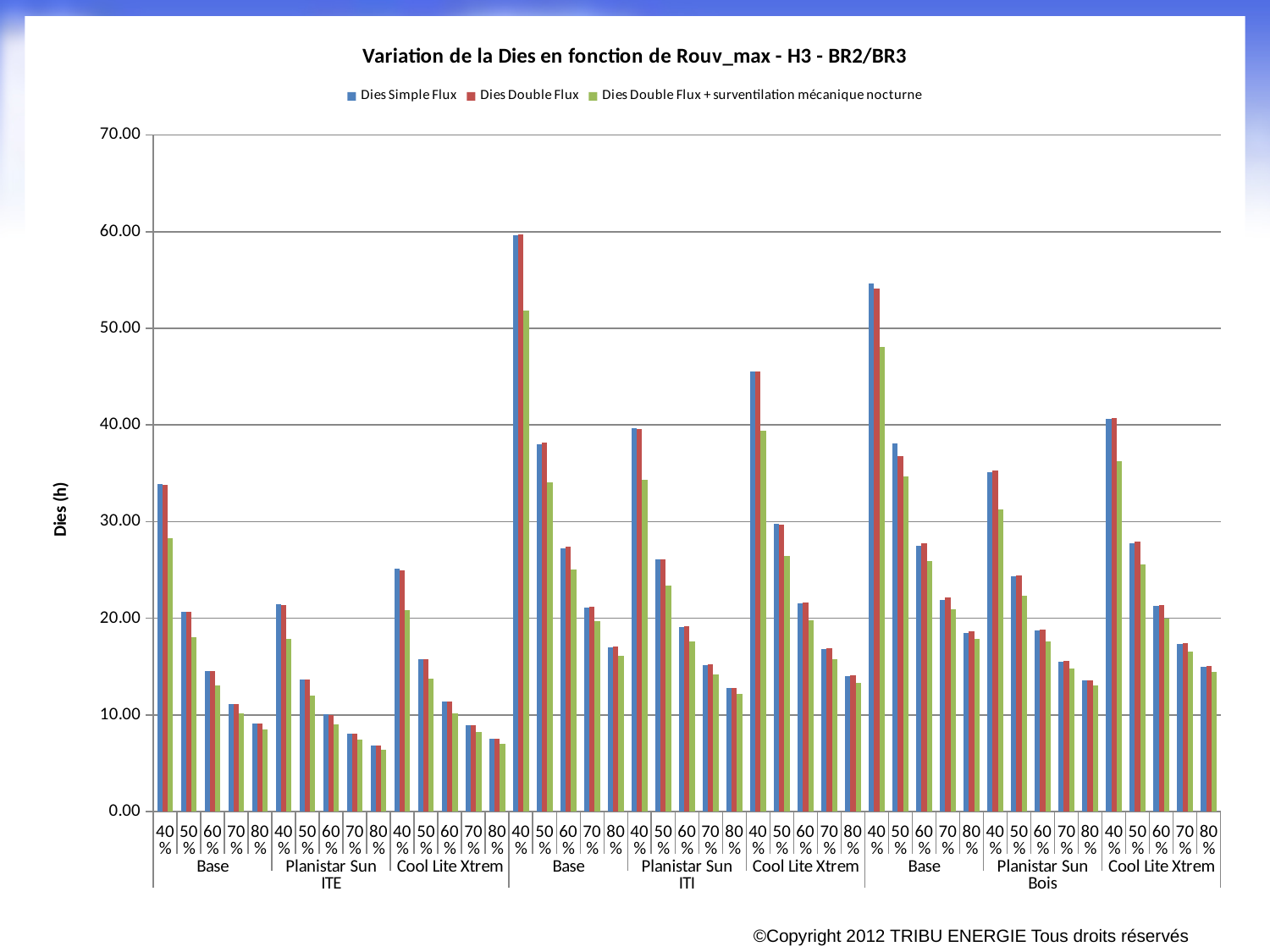
Is the Dies Simple Flux value for ITE Base 40% greater or less than 30.00? greater What is the label of the vertical axis? Dies (h) Is the Dies Simple Flux value for ITI Base 40% greater or less than 50.00? greater Is the Dies Simple Flux value for ITI Cool Lite Xtrem 40% greater or less than 40.00? greater What is the title of the chart? Variation de la Dies en fonction de Rouv_max - H3 - BR2/BR3 Which category has the highest bar on the chart? ITI, Base, 40% How many series does the legend list? 3 Within each glazing subgroup, do the Dies values rise or fall as Rouv_max increases from 40% to 80%? fall What kind of chart is shown on the slide? bar chart For Dies Simple Flux at 40%, which is larger: ITI Base or Bois Base? ITI Base How many top-level wall groups (ITE, ITI, Bois) are shown along the x axis? 3